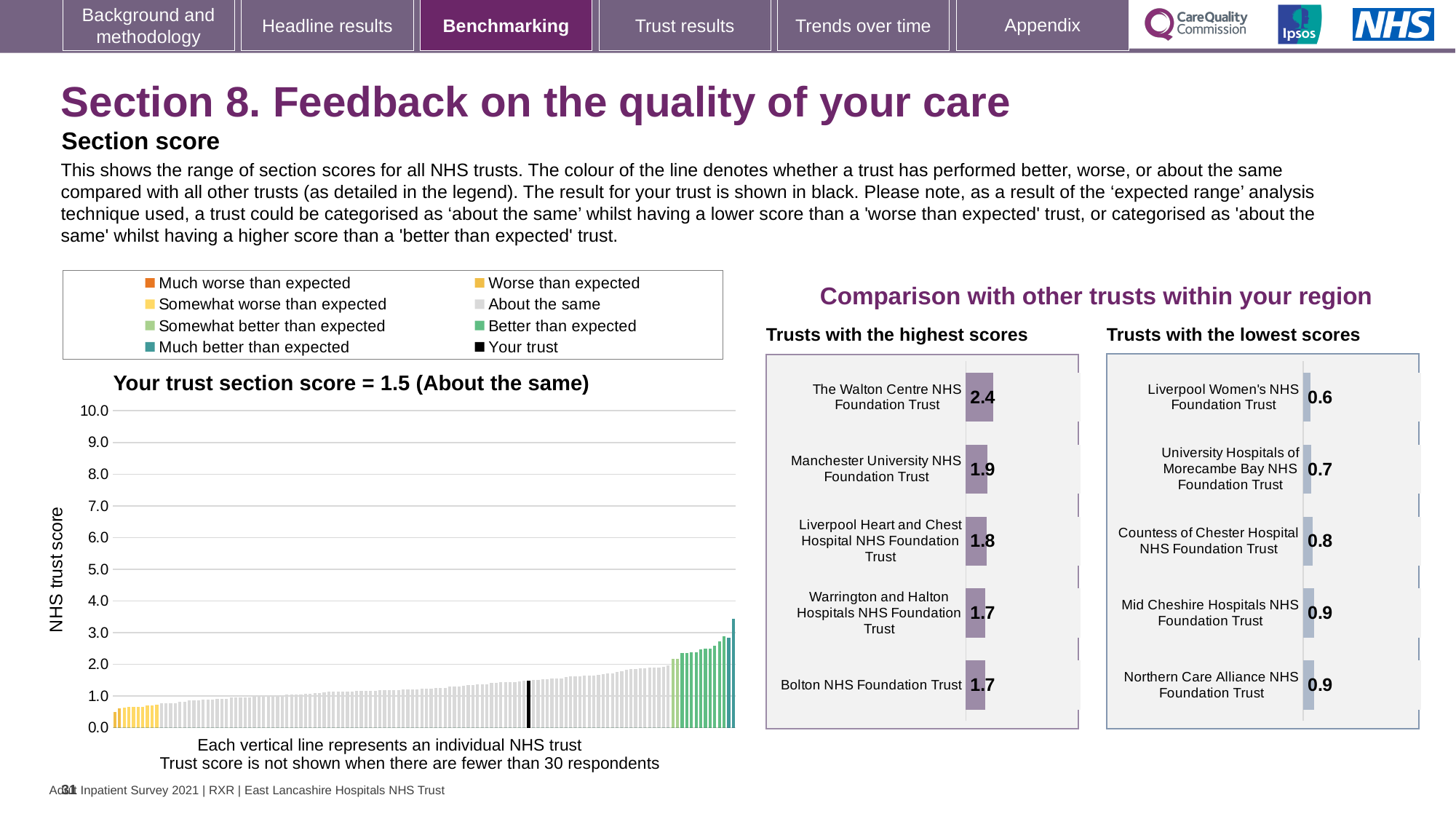
In the main 'Your trust section score' chart, is the highest trust score greater or less than 5.0? less In the 'Trusts with the highest scores' chart, what is the score for The Walton Centre NHS Foundation Trust? 2.4 How many trusts are shown in the 'Trusts with the lowest scores' chart? 5 In the main 'Your trust section score' chart, do the trust scores rise or fall from left to right along the x axis? rise How many entries does the legend above the main chart list? 8 In the main 'Your trust section score' chart, what is the section score for your trust? 1.5 In the 'Trusts with the highest scores' chart, what is the score for Liverpool Heart and Chest Hospital NHS Foundation Trust? 1.8 In the 'Trusts with the highest scores' chart, which trust has the highest score? The Walton Centre NHS Foundation Trust In the 'Trusts with the lowest scores' chart, what is the score for Countess of Chester Hospital NHS Foundation Trust? 0.8 In the 'Trusts with the lowest scores' chart, which trust has the lowest score? Liverpool Women's NHS Foundation Trust In the 'Trusts with the lowest scores' chart, which has the larger score: Liverpool Women's NHS Foundation Trust or Mid Cheshire Hospitals NHS Foundation Trust? Mid Cheshire Hospitals NHS Foundation Trust In the 'Trusts with the highest scores' chart, what is the difference between the scores of The Walton Centre NHS Foundation Trust and Manchester University NHS Foundation Trust? 0.5